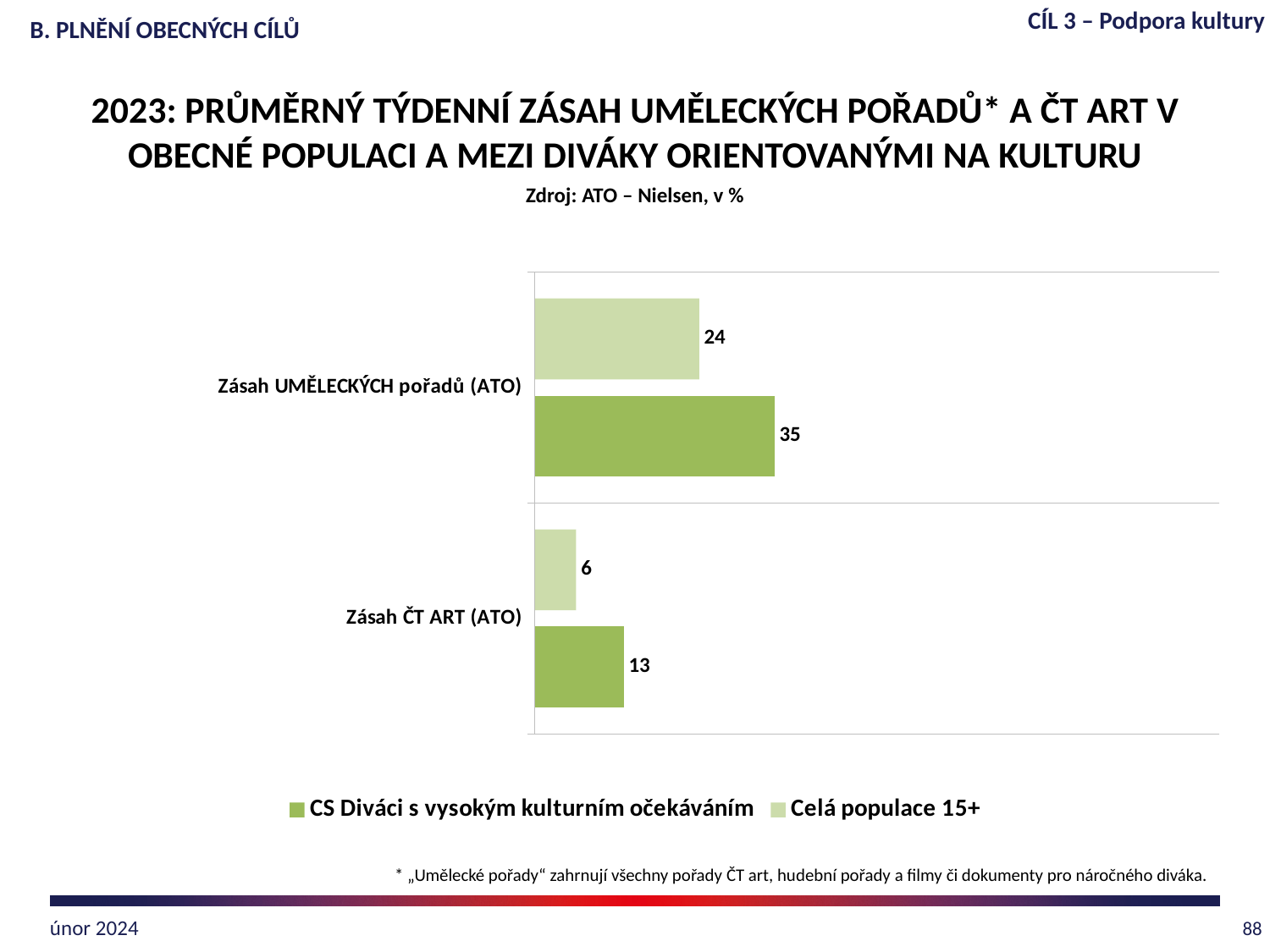
What is the value for 'Celá populace 15+' in the 'Zásah ČT ART (ATO)' category? 6 What is the value for 'CS Diváci s vysokým kulturním očekáváním' in the 'Zásah ČT ART (ATO)' category? 13 What kind of chart is shown on the slide? Bar chart What is the difference between the two series in the 'Zásah ČT ART (ATO)' category? 7 What is the value for 'CS Diváci s vysokým kulturním očekáváním' in the 'Zásah UMĚLECKÝCH pořadů (ATO)' category? 35 Which bar has the lowest value on the chart? Celá populace 15+, Zásah ČT ART (ATO) Which series has the larger value in the 'Zásah ČT ART (ATO)' category? CS Diváci s vysokým kulturním očekáváním What is the difference between the two series in the 'Zásah UMĚLECKÝCH pořadů (ATO)' category? 11 Which bar has the highest value on the chart? CS Diváci s vysokým kulturním očekáváním, Zásah UMĚLECKÝCH pořadů (ATO) How many categories are shown on the chart? 2 How many series does the legend list? 2 What is the value for 'Celá populace 15+' in the 'Zásah UMĚLECKÝCH pořadů (ATO)' category? 24